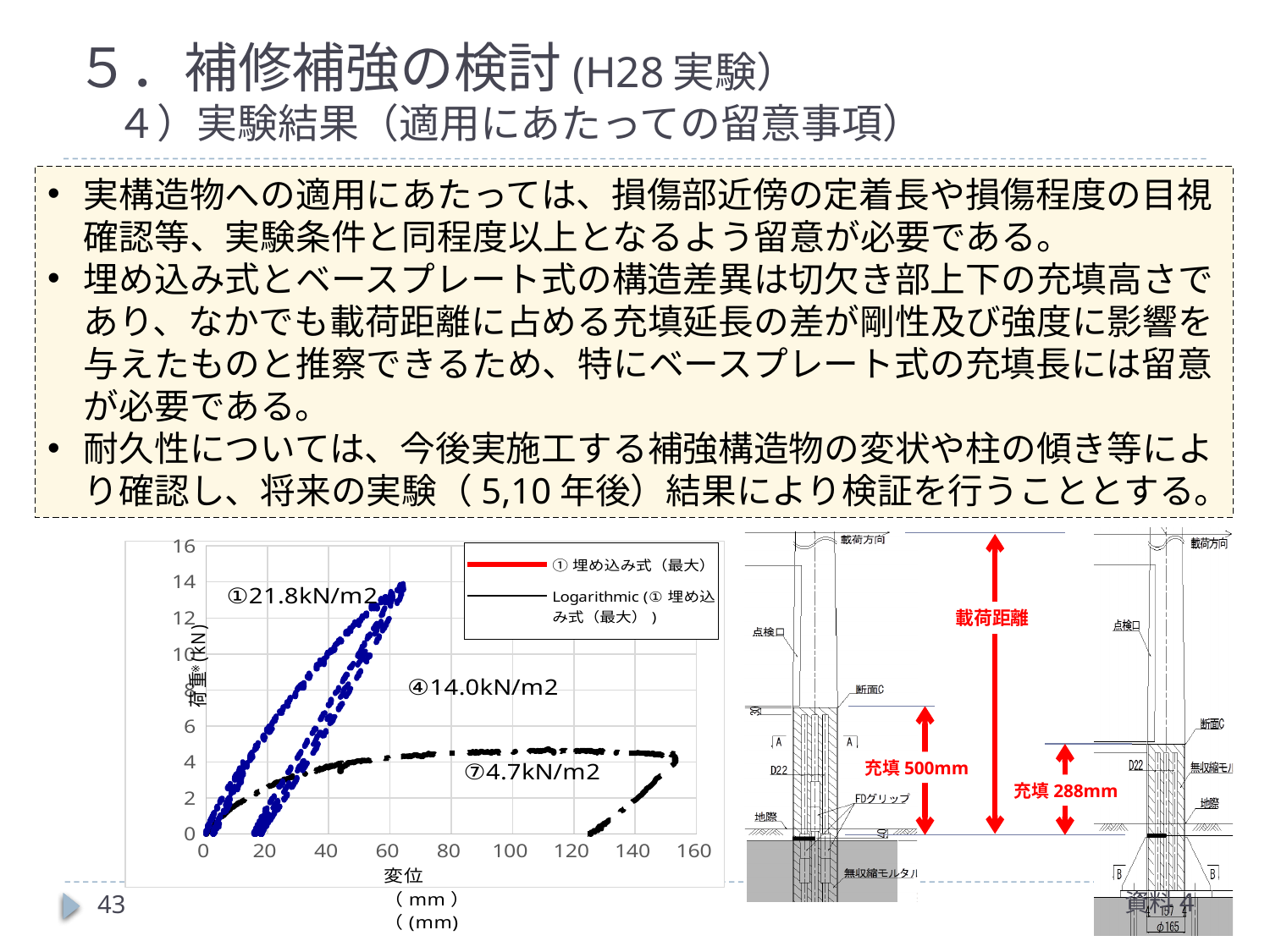
What is the label of the y axis of the chart? 荷重*(kN) How many entries does the legend of the chart list? 2 Is the maximum load reached by the black dashed curve greater or less than 6 kN? less What value is printed in the annotation labelled ④ on the chart? 14.0kN/m2 Which annotation on the chart shows the smallest value: ①, ④ or ⑦? ⑦ Which annotation on the chart shows the largest value: ①, ④ or ⑦? ① What value is printed in the annotation labelled ⑦ on the chart? 4.7kN/m2 What value is printed in the annotation labelled ① on the chart? 21.8kN/m2 Is the peak load reached by the blue ① 埋め込み式 curve greater or less than 12 kN? greater What is the label of the x axis of the chart? 変位 (mm) What kind of chart is shown at the bottom left of the slide? scatter chart What is the highest tick value shown on the x axis of the chart? 160